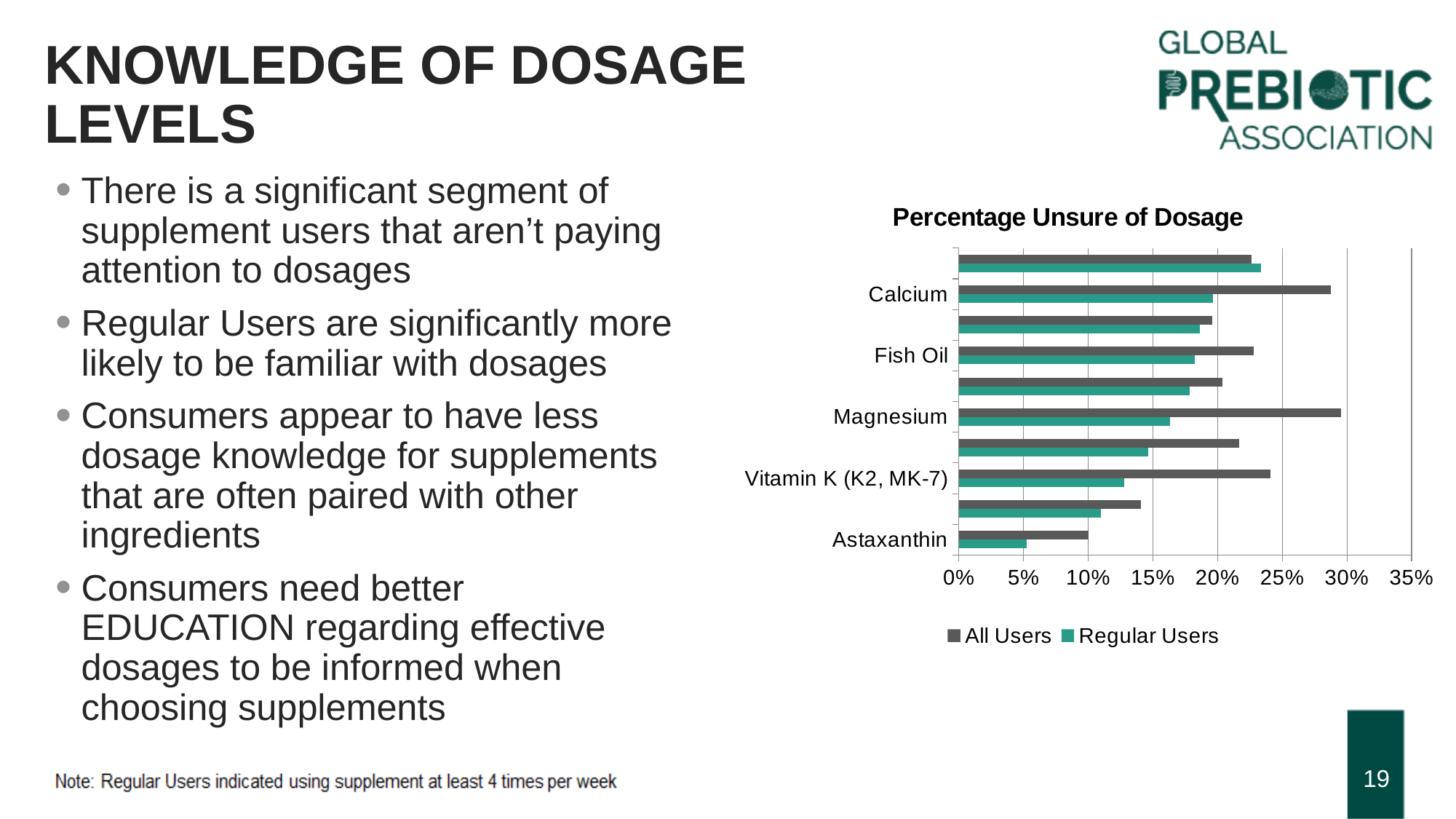
For Calcium, which is larger: the All Users value or the Regular Users value? All Users How many series does the chart legend list? 2 Which series is shown in teal/green in the chart? Regular Users Is the All Users value for Calcium greater or less than 25%? greater Is the Regular Users value for Astaxanthin greater or less than 10%? less Is the Regular Users value for Fish Oil greater or less than 20%? less What kind of chart is shown on the slide? Bar chart Which labeled category has the lowest All Users value? Astaxanthin What is the title of the chart? Percentage Unsure of Dosage